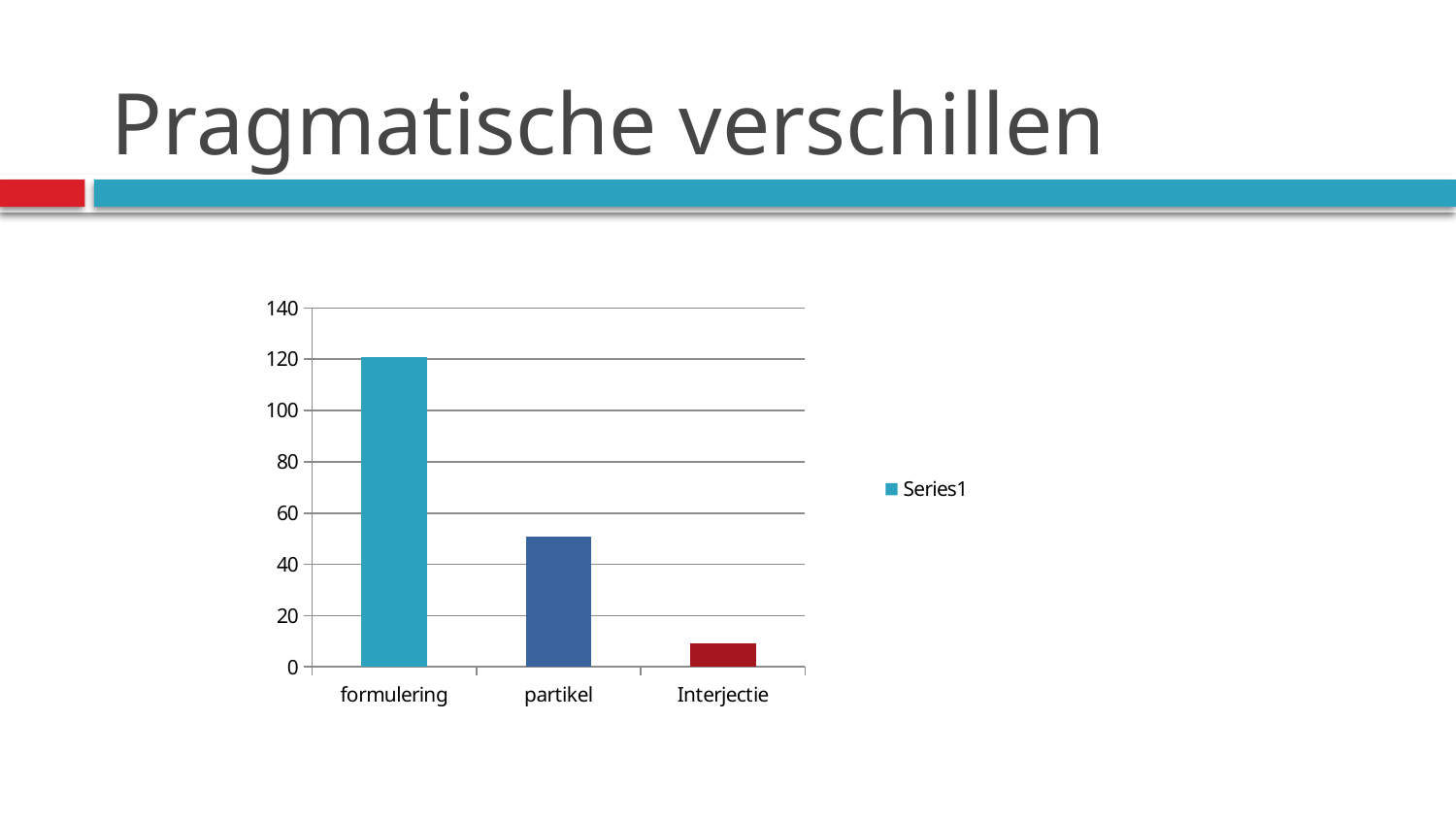
What kind of chart is shown on the slide? bar chart Which category has the highest bar in the chart? formulering Is the value for Interjectie greater or less than 20? less What is the name of the series listed in the chart's legend? Series1 Is the value for partikel greater or less than 40? greater Which category has the lowest bar in the chart? Interjectie How many series does the chart's legend list? 1 How many categories are shown on the x axis of the chart? 3 Is the value for formulering greater or less than 100? greater Do the bar values rise or fall from left to right along the x axis? fall Which is larger, the value for partikel or the value for Interjectie? partikel